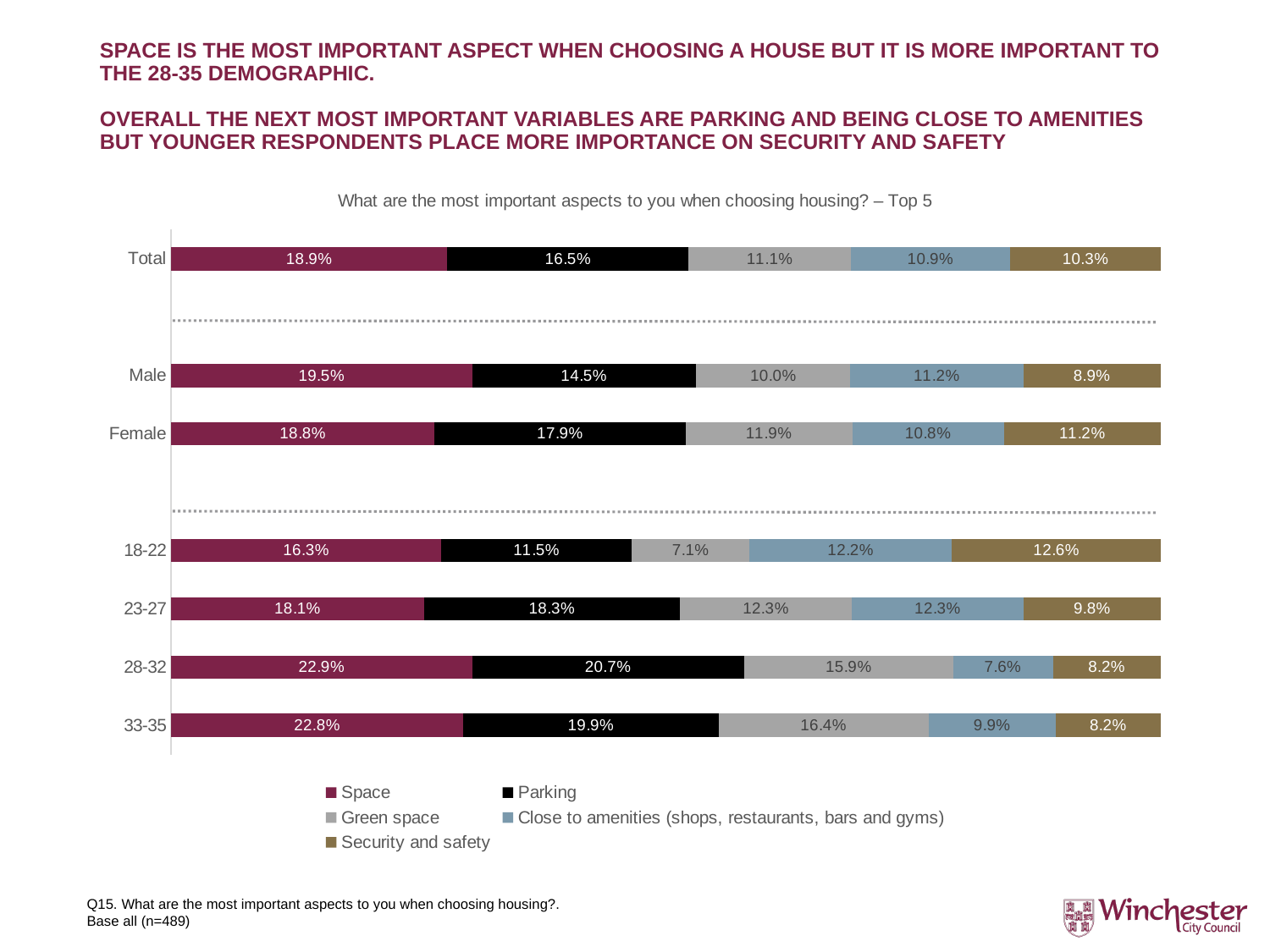
What is the value for Green space in the Female bar? 11.9% What is the value for Parking in the 28-32 bar? 20.7% What is the value for Close to amenities (shops, restaurants, bars and gyms) in the 33-35 bar? 9.9% How many series does the legend list? 5 What kind of chart is shown on the slide? Stacked bar chart What is the value for Space in the Total bar? 18.9% Which category has the lowest value for Parking? 18-22 What is the value for Security and safety in the 18-22 bar? 12.6% Which category has the highest value for Security and safety? 18-22 What is the difference between the Space values for Male and Female? 0.7 percentage points For the 23-27 category, which is larger: Space or Parking? Parking How many categories (bars) are shown on the chart? 7